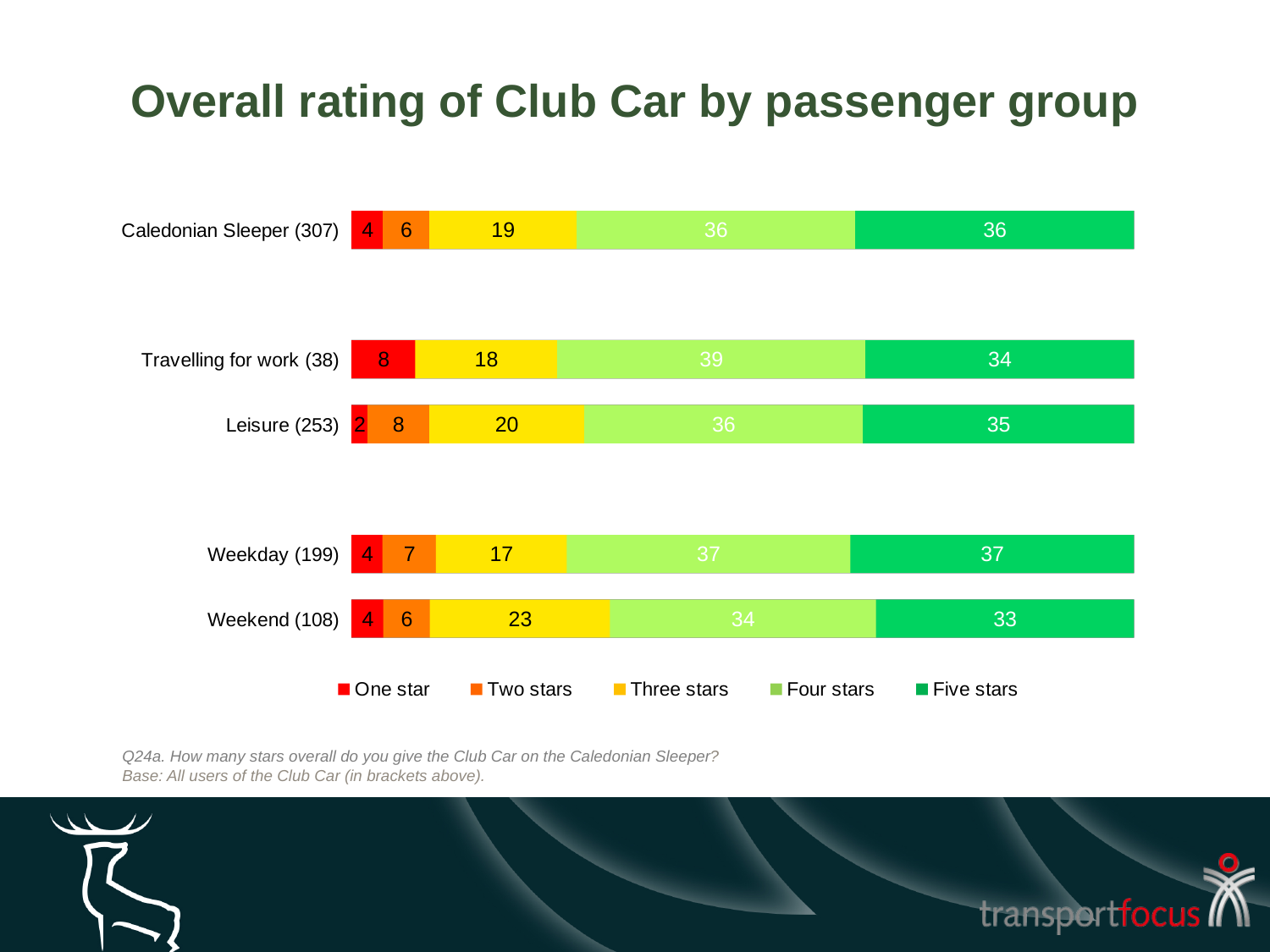
What is the Three stars value for Weekend (108)? 23 Which passenger group has the lowest Five stars value? Weekend (108) What is the Five stars value for Weekday (199)? 37 How many passenger groups are shown in the chart? 5 Which passenger group has the highest Three stars value? Weekend (108) What kind of chart is shown on the slide? Stacked bar chart Which is larger: the Two stars value for Leisure (253) or the Two stars value for Weekday (199)? Leisure (253) What is the total of the labelled segments for Weekend (108)? 100 For Travelling for work (38), what is the difference between the Four stars value and the Five stars value? 5 How many series does the legend list? 5 What is the One star value for Leisure (253)? 2 What is the Four stars value for Travelling for work (38)? 39